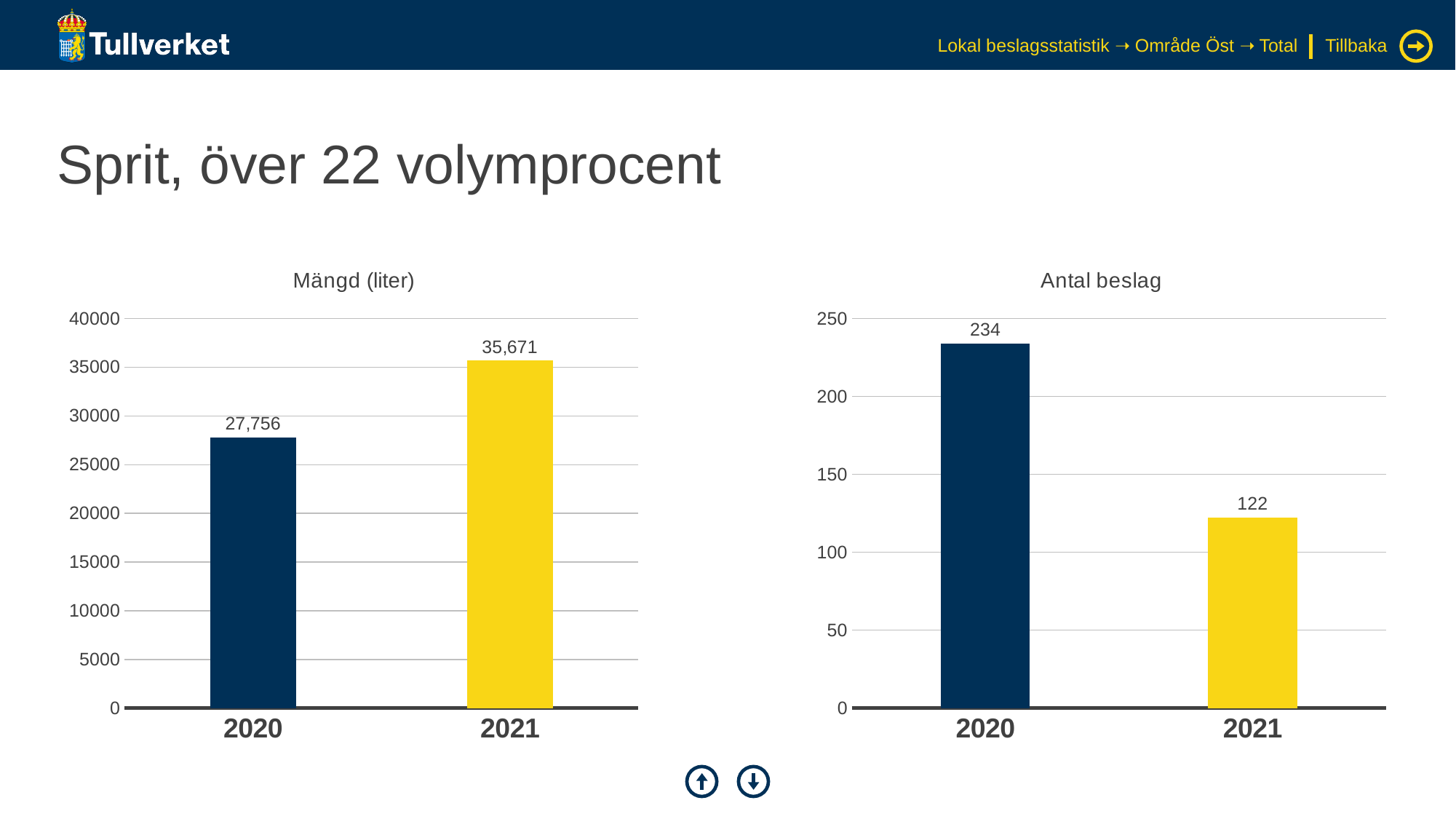
In the 'Mängd (liter)' chart, what is the difference between the 2021 and 2020 values? 7,915 What kind of chart is the 'Mängd (liter)' chart? bar chart How many bars are shown in the 'Antal beslag' chart? 2 In the 'Mängd (liter)' chart, what is the value for 2020? 27,756 In the 'Mängd (liter)' chart, which year has the highest value? 2021 In the 'Mängd (liter)' chart, do the values rise or fall from 2020 to 2021? rise In the 'Antal beslag' chart, is the value for 2020 greater or less than 200? greater In the 'Mängd (liter)' chart, what is the value for 2021? 35,671 In the 'Antal beslag' chart, which year has the lowest value? 2021 In the 'Antal beslag' chart, what is the value for 2021? 122 In the 'Antal beslag' chart, what is the value for 2020? 234 In the 'Antal beslag' chart, what is the difference between the 2020 and 2021 values? 112